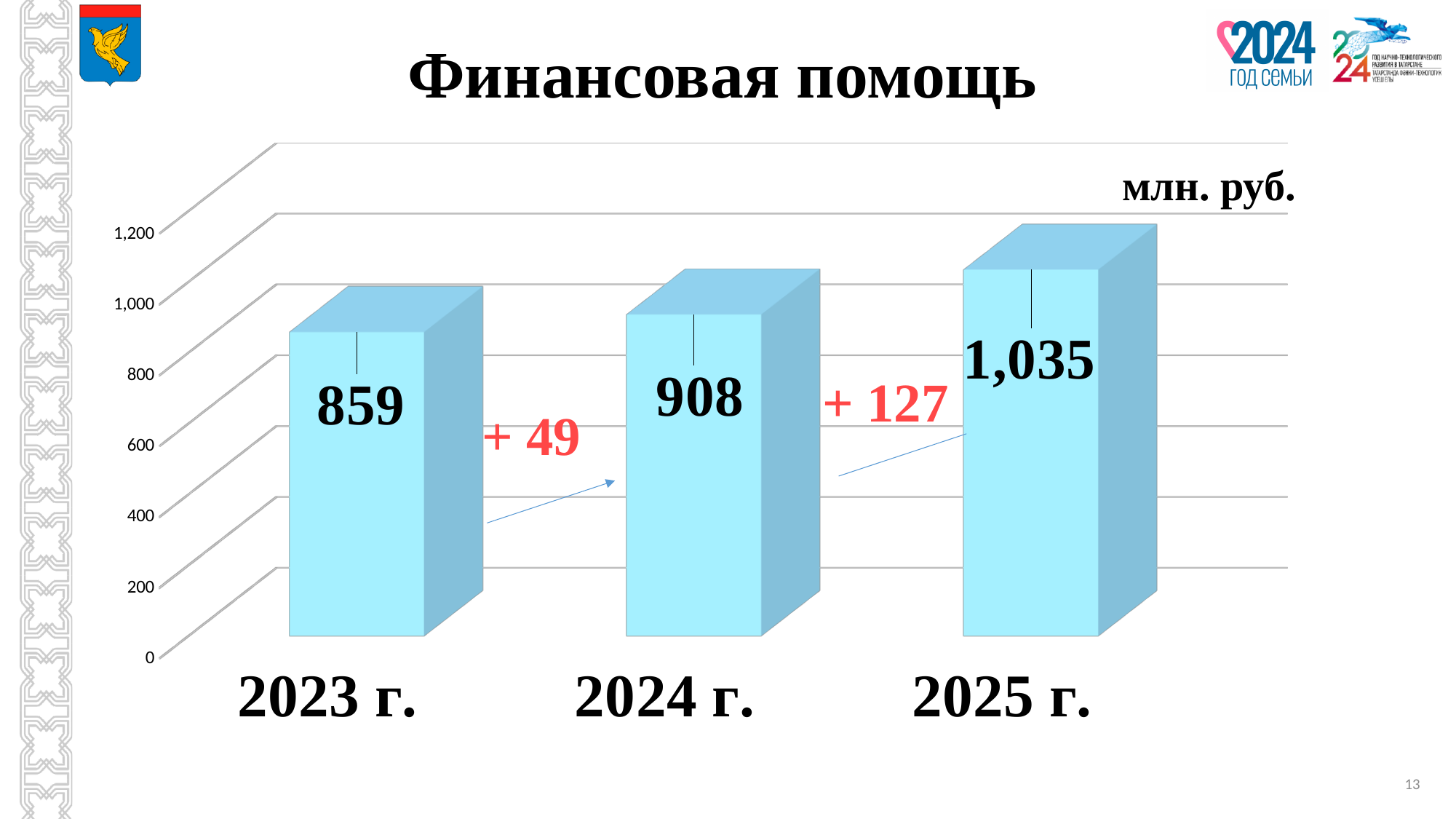
What kind of chart is shown on the slide? bar chart Which year has the highest value? 2025 г. What is the value for 2024 г.? 908 Do the values rise or fall from 2023 г. to 2025 г.? rise What is the difference between the values for 2025 г. and 2024 г.? 127 Which is larger, the value for 2023 г. or the value for 2025 г.? 2025 г. What is the value for 2025 г.? 1,035 Is the value for 2025 г. greater or less than 1,000? greater What is the value for 2023 г.? 859 What is the difference between the values for 2024 г. and 2023 г.? 49 Which year has the lowest value? 2023 г. How many years are shown on the chart? 3